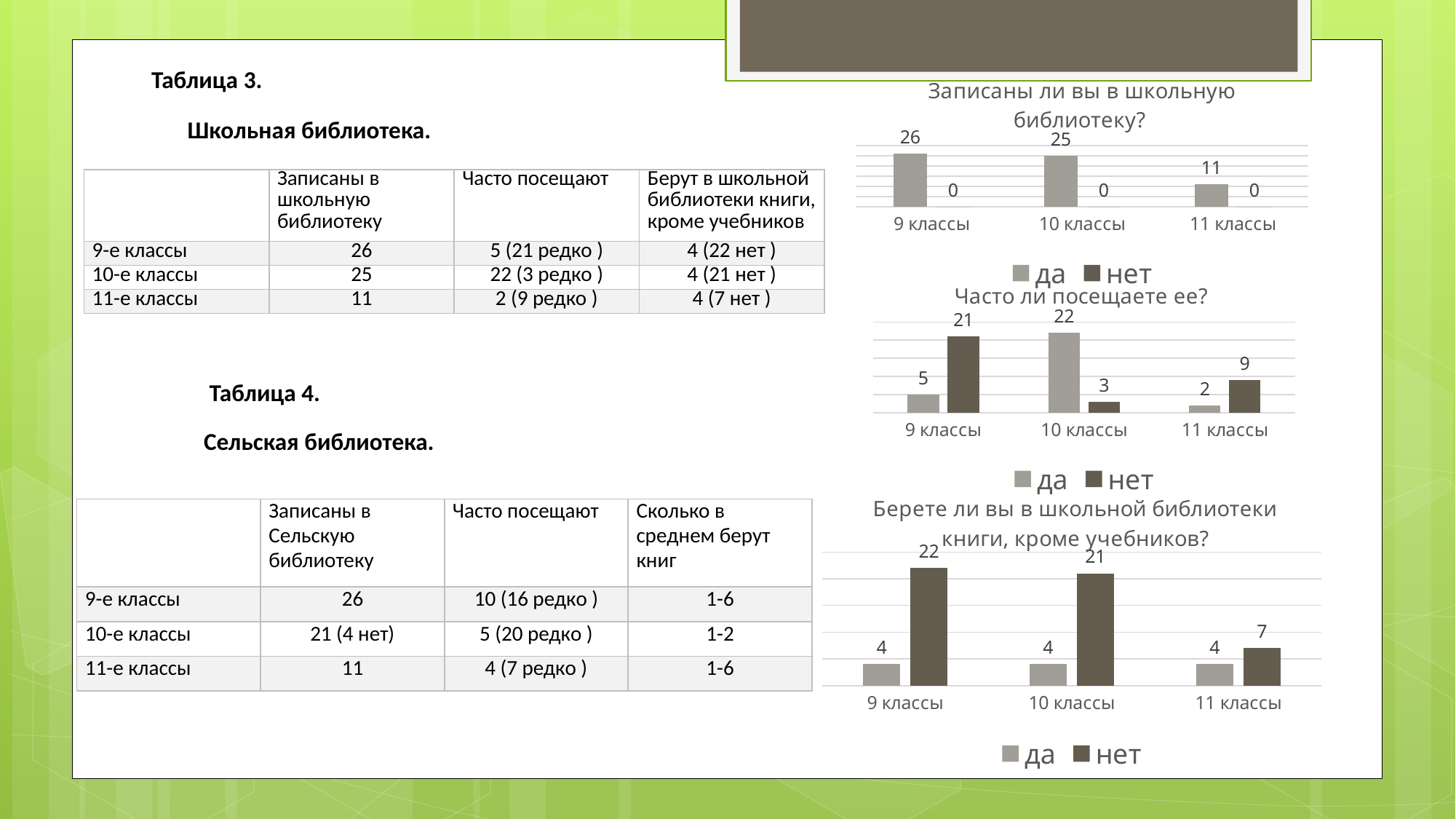
How many series does the legend of the chart 'Часто ли посещаете ее?' list? 2 In the chart 'Часто ли посещаете ее?', what is the difference between 'нет' and 'да' for 11 классы? 7 In the chart 'Часто ли посещаете ее?', what is the value of 'нет' for 9 классы? 21 In the chart 'Берете ли вы в школьной библиотеки книги, кроме учебников?', what is the difference between 'нет' and 'да' for 9 классы? 18 In the chart 'Берете ли вы в школьной библиотеки книги, кроме учебников?', what is the value of 'нет' for 10 классы? 21 In the chart 'Записаны ли вы в школьную библиотеку?', what is the value of 'да' for 9 классы? 26 In the chart 'Берете ли вы в школьной библиотеки книги, кроме учебников?', which class group has the lowest 'нет' value? 11 классы What kind of chart is 'Берете ли вы в школьной библиотеки книги, кроме учебников?'? bar chart In the chart 'Часто ли посещаете ее?', which is larger for 10 классы: 'да' or 'нет'? да In the chart 'Часто ли посещаете ее?', which class group has the highest 'да' value? 10 классы In the chart 'Записаны ли вы в школьную библиотеку?', what is the value of 'нет' for 10 классы? 0 In the chart 'Записаны ли вы в школьную библиотеку?', which class group has the lowest 'да' value? 11 классы